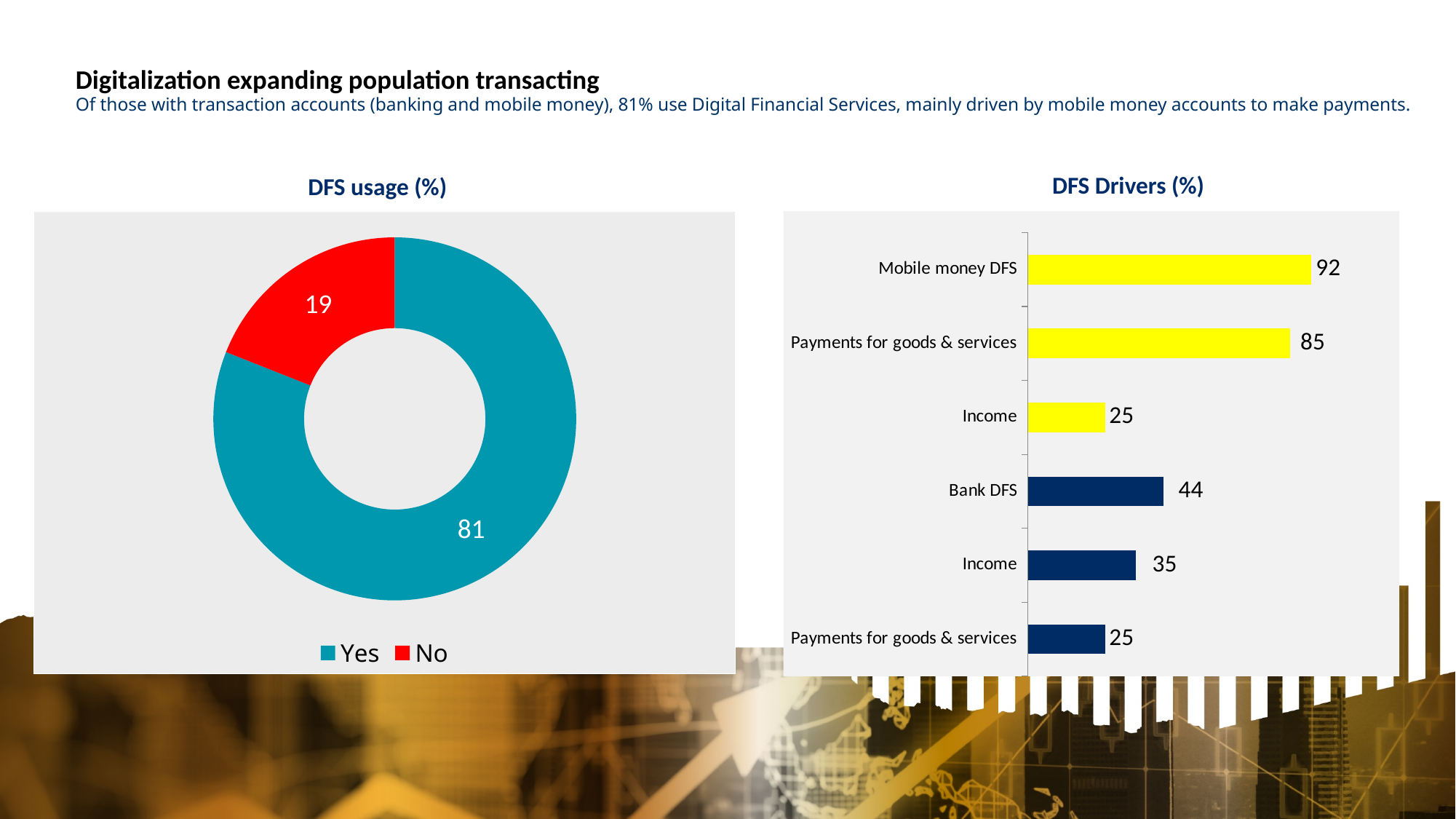
What kind of chart is the DFS Drivers (%) chart? Bar chart In the DFS Drivers (%) chart, what is the value for Mobile money DFS? 92 What kind of chart is the DFS usage (%) chart? Donut (pie) chart How many entries does the legend of the DFS usage (%) chart list? 2 In the DFS Drivers (%) chart, what is the value for Bank DFS? 44 In the DFS Drivers (%) chart, which category has the highest value? Mobile money DFS In the DFS usage (%) chart, what is the value for Yes? 81 In the DFS Drivers (%) chart, which is larger: the yellow Income bar or the dark blue Income bar? The dark blue Income bar (35) In the DFS Drivers (%) chart, what is the difference between Mobile money DFS and Bank DFS? 48 In the DFS usage (%) chart, what is the difference between the Yes and No values? 62 How many bars are shown in the DFS Drivers (%) chart? 6 In the DFS usage (%) chart, what is the value for No? 19